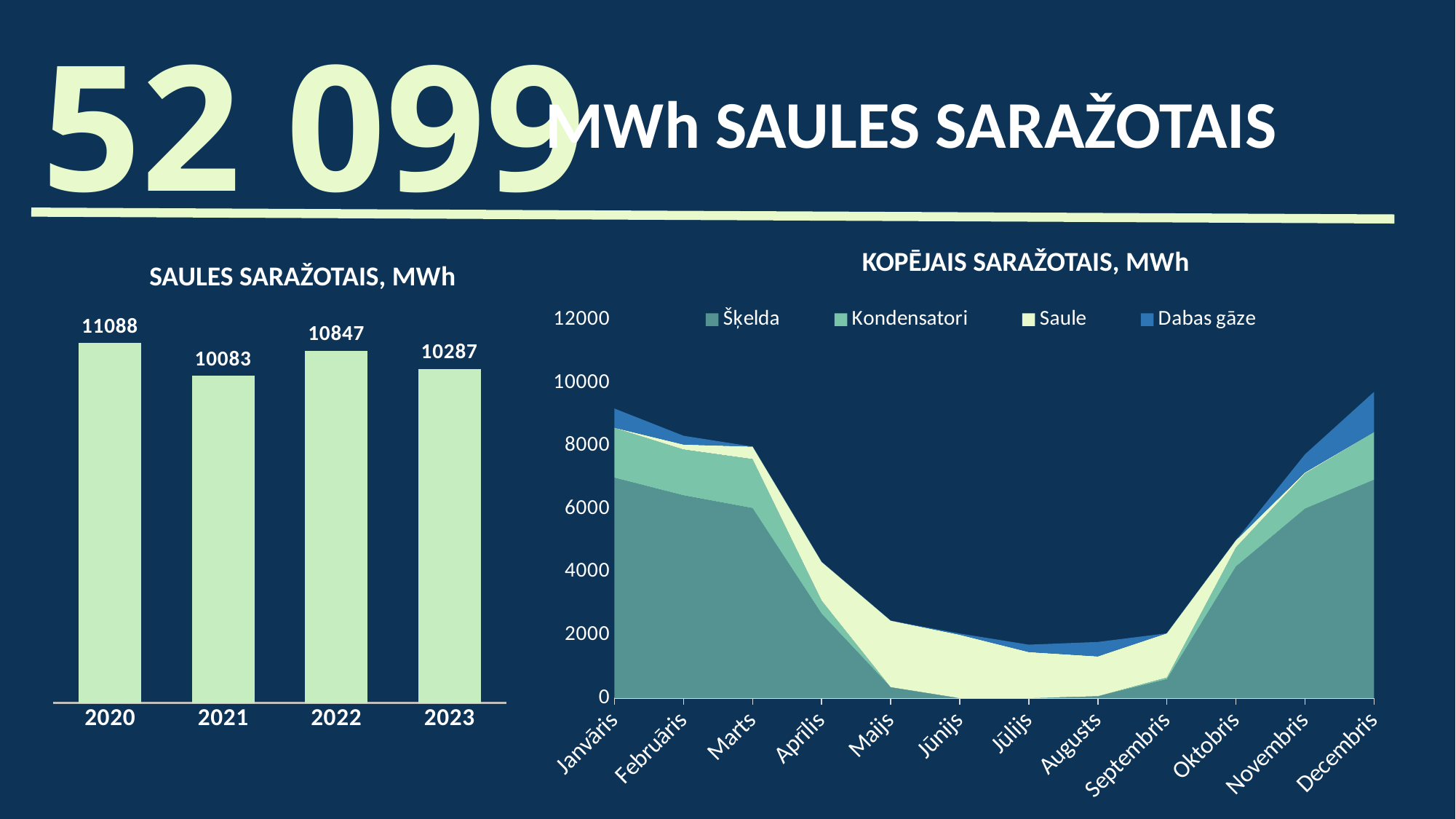
In the chart titled "KOPĒJAIS SARAŽOTAIS, MWh", how many months are shown on the x axis? 12 In the chart titled "SAULES SARAŽOTAIS, MWh", what is the value for 2020? 11088 In the chart titled "SAULES SARAŽOTAIS, MWh", what is the value for 2023? 10287 In the chart titled "KOPĒJAIS SARAŽOTAIS, MWh", is the total value for Jūlijs greater or less than 4000? less In the chart titled "KOPĒJAIS SARAŽOTAIS, MWh", how many series does the legend list? 4 In the chart titled "SAULES SARAŽOTAIS, MWh", which year has the lowest value? 2021 In the chart titled "SAULES SARAŽOTAIS, MWh", which is larger, the value for 2022 or the value for 2023? 2022 In the chart titled "KOPĒJAIS SARAŽOTAIS, MWh", which series is shown in blue according to the legend? Dabas gāze In the chart titled "SAULES SARAŽOTAIS, MWh", which year has the highest value? 2020 In the chart titled "SAULES SARAŽOTAIS, MWh", how many years are shown? 4 What kind of chart is the chart titled "SAULES SARAŽOTAIS, MWh"? bar chart In the chart titled "SAULES SARAŽOTAIS, MWh", what is the difference between the values for 2020 and 2021? 1005